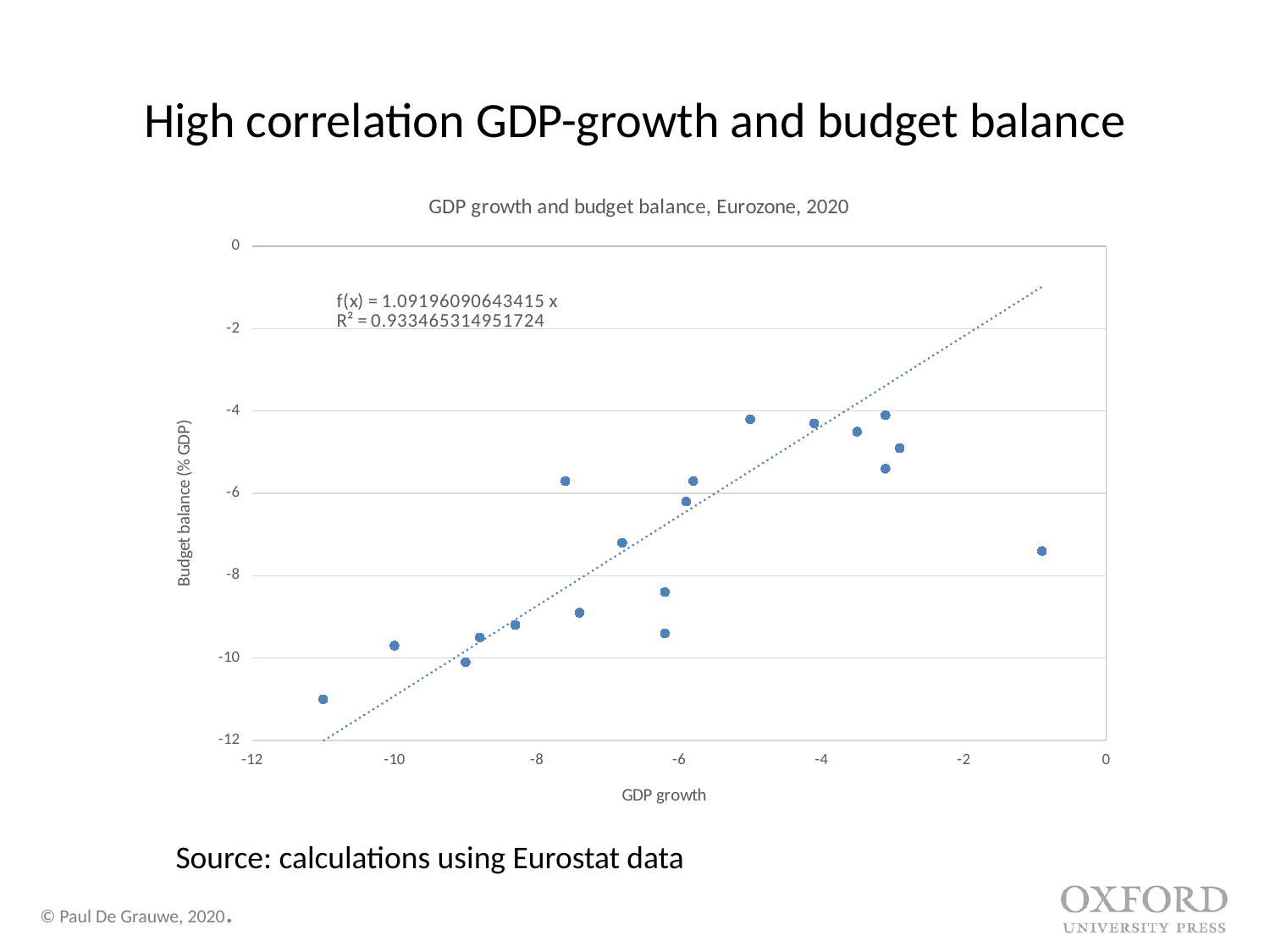
Is the budget balance of the point with the highest GDP growth (the rightmost point) greater or less than -6? less Is the slope of the fitted trendline greater or less than 1? greater What is the R² value printed on the chart? 0.933465314951724 Is the lowest budget balance value plotted on the chart greater or less than -10? less As GDP growth increases along the x axis, does the budget balance generally rise or fall? Rise What is the label of the vertical axis of the chart? Budget balance (% GDP) What is the trendline equation printed on the chart? f(x) = 1.09196090643415 x What is the lowest value shown on the x axis of the chart? -12 Is the GDP growth of the leftmost point greater or less than -10? less Are all the plotted GDP growth values negative? Yes What is the title of the chart? GDP growth and budget balance, Eurozone, 2020 What kind of chart is shown on the slide? Scatter chart